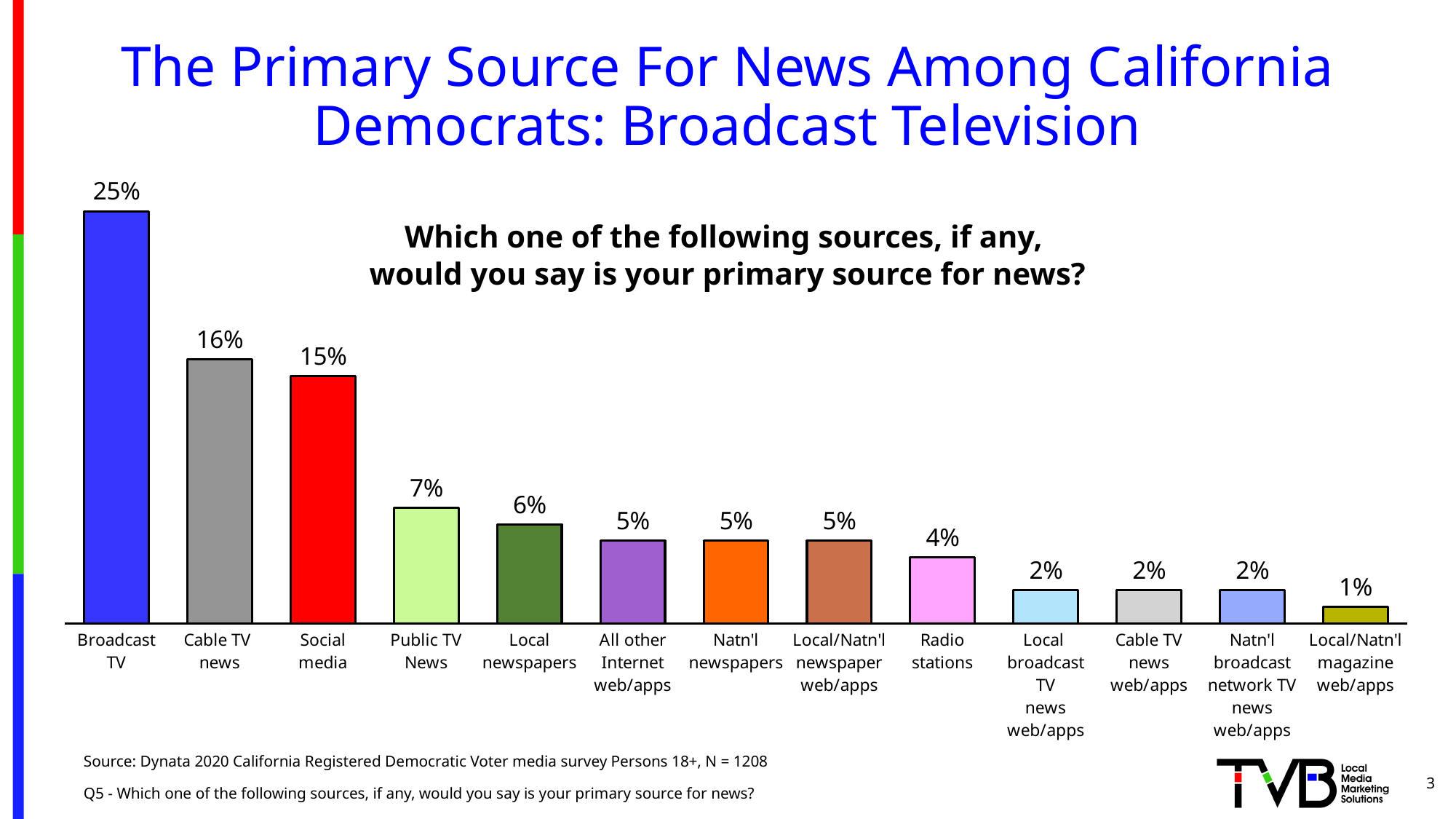
Which source has the lowest percentage? Local/Natn'l magazine web/apps What is the value shown for Radio stations? 4% What percentage of California Democrats name Broadcast TV as their primary source for news? 25% What is the value shown for Public TV News? 7% What kind of chart is shown on the slide? Bar chart What is the difference between the values for Social media and Local newspapers? 9 percentage points Do the values rise or fall moving from left to right across the chart? Fall How many sources (categories) are shown in the chart? 13 What is the difference between the values for Broadcast TV and Cable TV news? 9 percentage points Which is larger, the value for Cable TV news or the value for Public TV News? Cable TV news What is the value shown for Social media? 15% Which source has the highest percentage? Broadcast TV